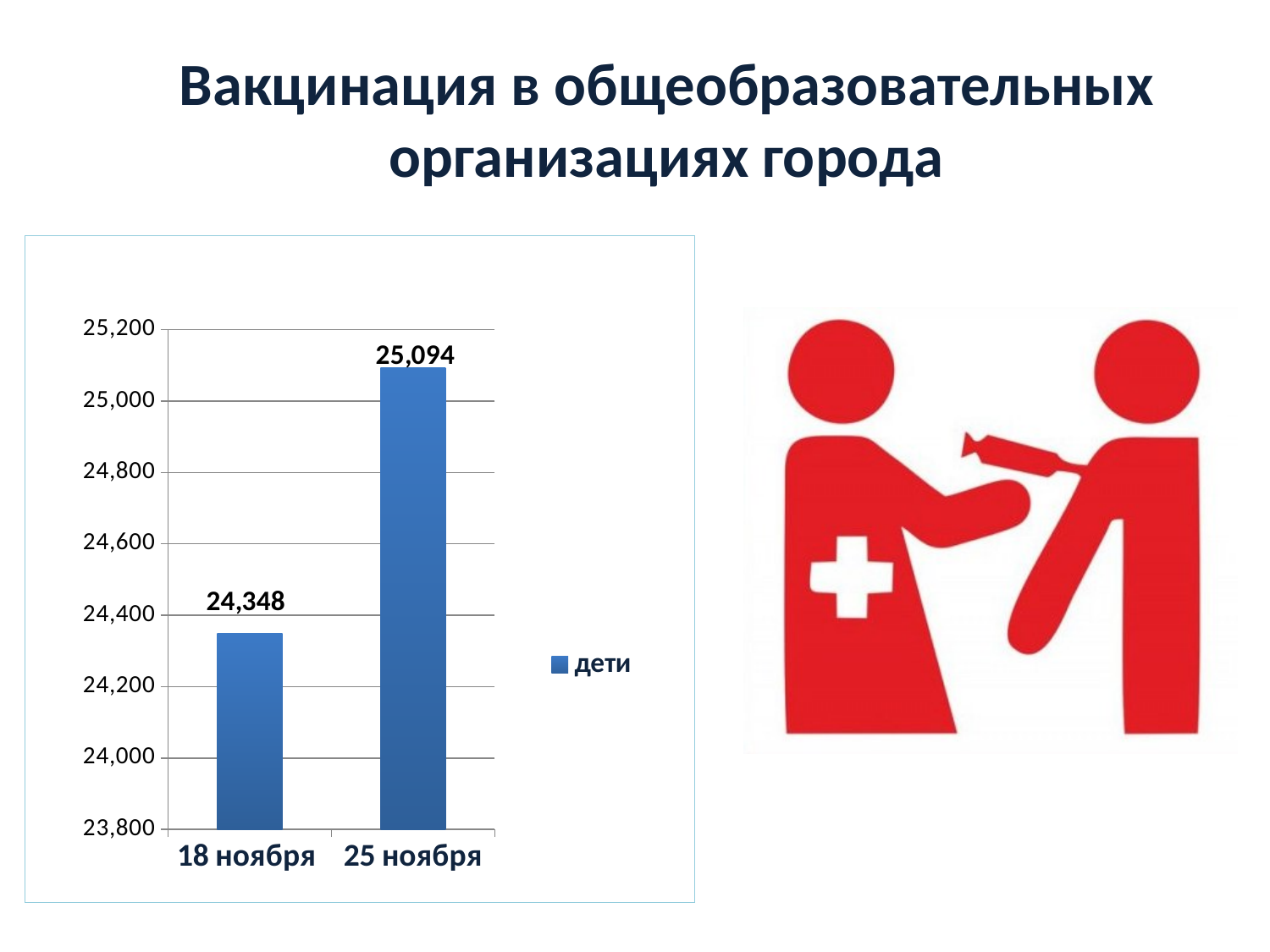
What is the name of the series in the legend? дети What is the difference between the values for 25 ноября and 18 ноября? 746 What is the value for 25 ноября? 25,094 Is the value for 18 ноября greater or less than 24,400? less How many categories are shown on the x axis? 2 Which category has the highest value? 25 ноября Which category has the lowest value? 18 ноября Which is larger, the value for 18 ноября or the value for 25 ноября? 25 ноября How many series does the legend list? 1 What is the value for 18 ноября? 24,348 Is the value for 25 ноября greater or less than 25,000? greater What kind of chart is shown on the slide? bar chart